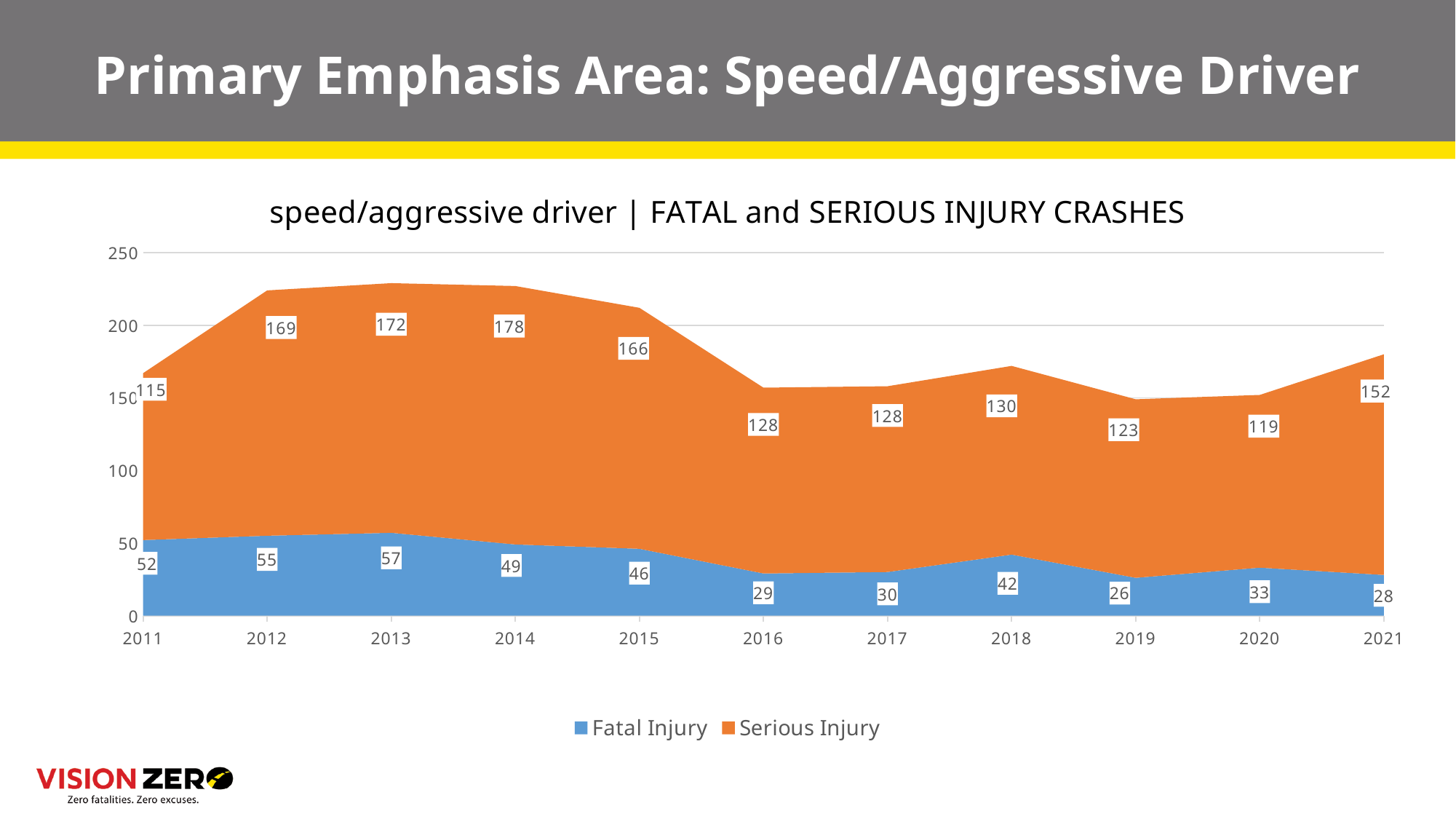
What kind of chart is shown on the slide? Stacked area chart Is the Fatal Injury value for 2018 larger than the Fatal Injury value for 2017? Yes What is the Serious Injury value for 2014? 178 What is the Fatal Injury value for 2013? 57 What is the difference between the Serious Injury values for 2013 and 2020? 53 Which year has the lowest Serious Injury value? 2011 Which year has the highest Serious Injury value? 2014 How many series does the legend list? 2 What is the Serious Injury value for 2021? 152 Which year has the lowest Fatal Injury value? 2019 How many years are shown on the x axis? 11 What is the total of Fatal Injury and Serious Injury for 2012? 224